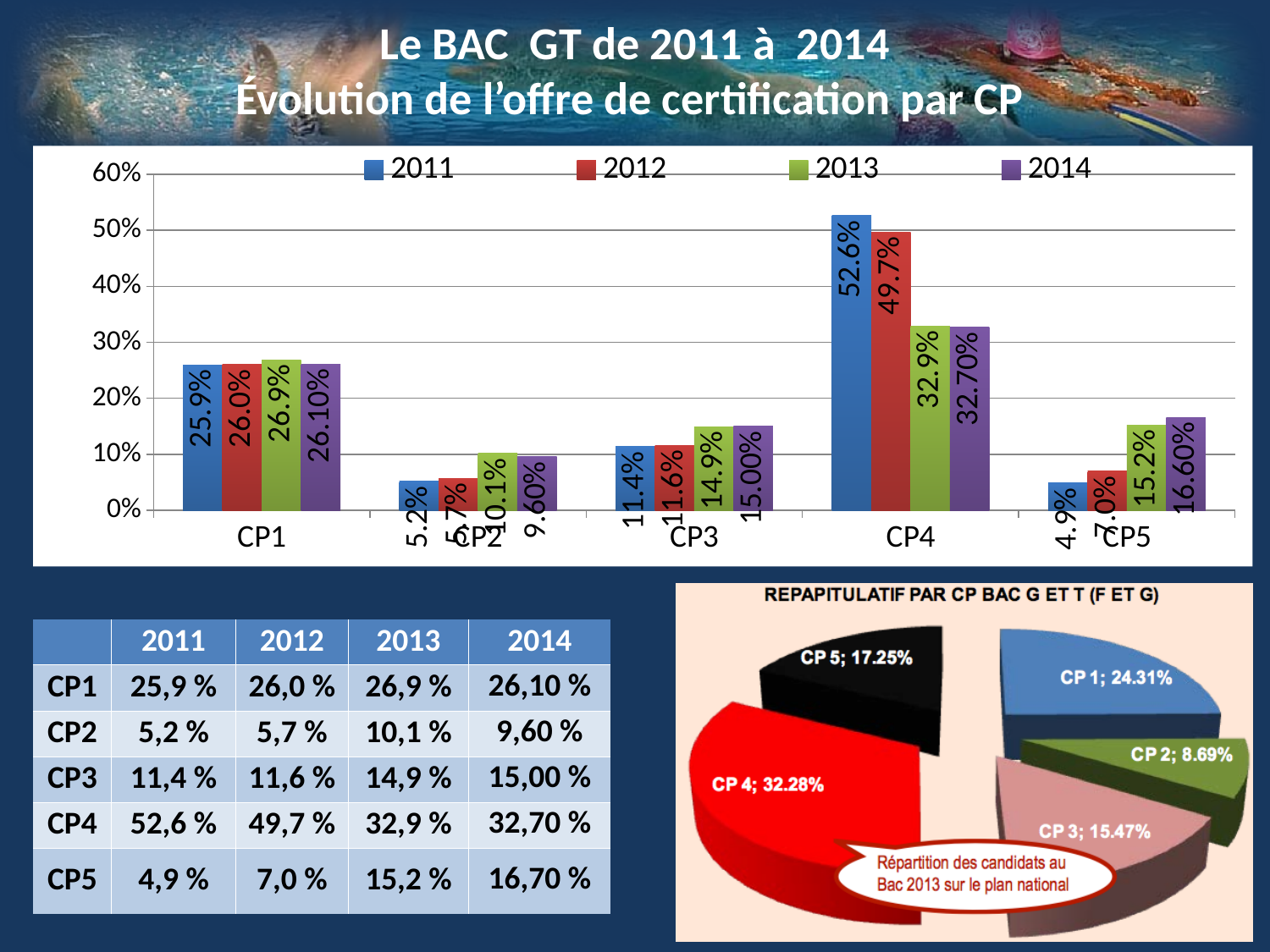
In the bar chart, what is the value for CP1 in 2014? 26.10% In the pie chart at the bottom right, what share does CP 4 have? 32.28% How many series does the legend of the bar chart list? 4 In the bar chart, which is larger: the 2013 value for CP2 or the 2013 value for CP3? CP3 (14.9%) What kind of chart is shown at the bottom right of the slide? pie chart In the bar chart, what is the value for CP3 in 2013? 14.9% In the bar chart, what is the difference between the 2011 and 2014 values for CP4? 19.9% How many categories are shown on the x axis of the bar chart? 5 In the bar chart, do the values for CP4 rise or fall from 2011 to 2014? fall In the bar chart, which category has the highest value for 2012? CP4 In the bar chart, which category has the lowest value for 2011? CP5 In the bar chart, what is the value for CP4 in 2011? 52.6%